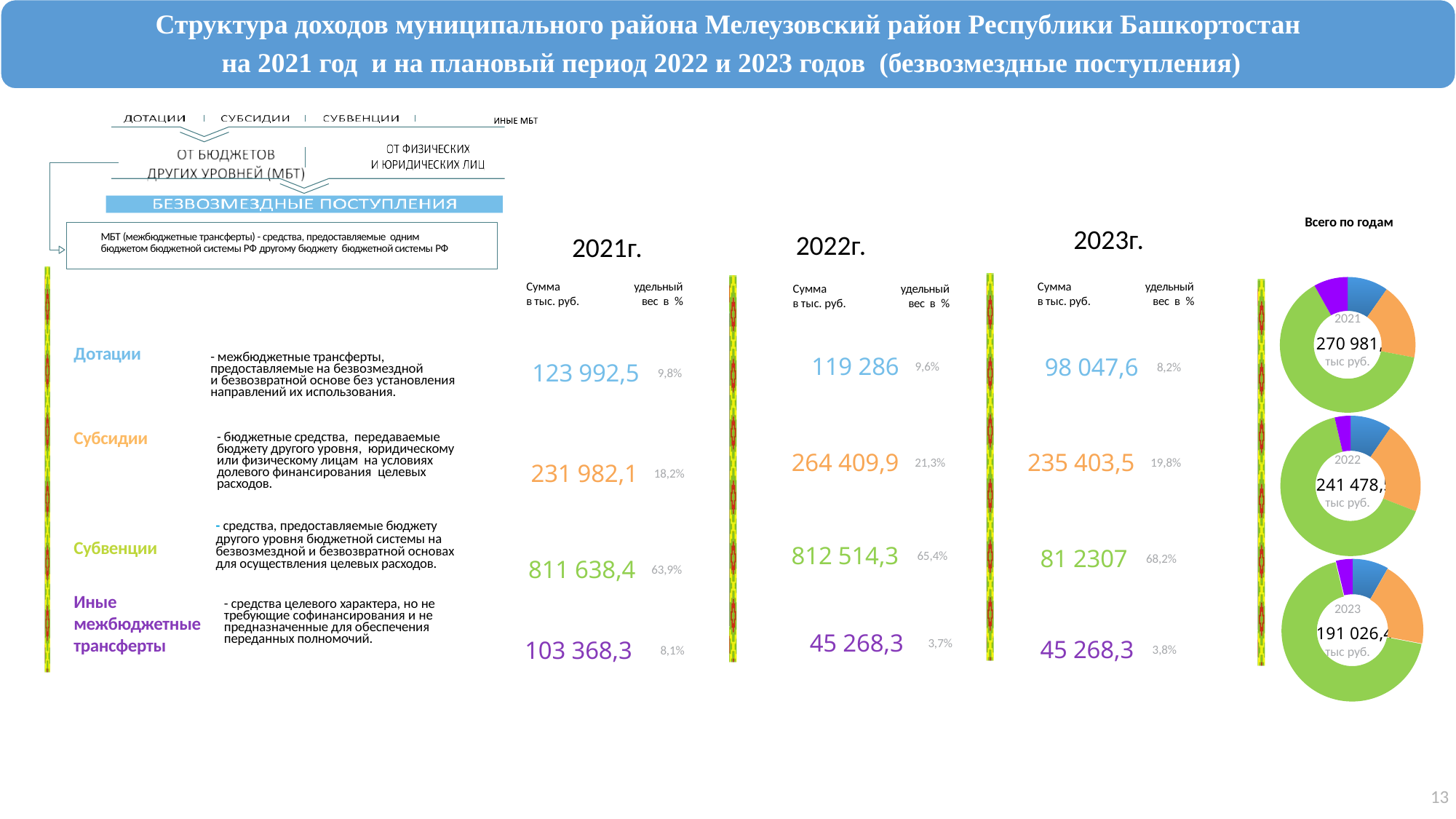
What share of the 2021 total do Субвенции make up? 63,9% In the 2022 donut chart, which category is the smallest slice? Иные межбюджетные трансферты What is the heading above the three donut charts? Всего по годам In the 2021 donut chart, which category does the largest (green) slice represent? Субвенции How many donut charts are shown under "Всего по годам"? 3 Does the share of Субвенции rise or fall from 2021 to 2023? rise In the 2021 donut chart, is the orange slice (Субсидии) larger or smaller than the blue slice (Дотации)? larger How many slices does the 2021 donut chart have? 4 What kind of chart is used in the "Всего по годам" section on the right of the slide? donut (pie) chart What share of the 2023 total do Дотации make up? 8,2% What share of the 2022 total do Субсидии make up? 21,3% In the 2023 donut chart, which category is the smallest slice? Иные межбюджетные трансферты